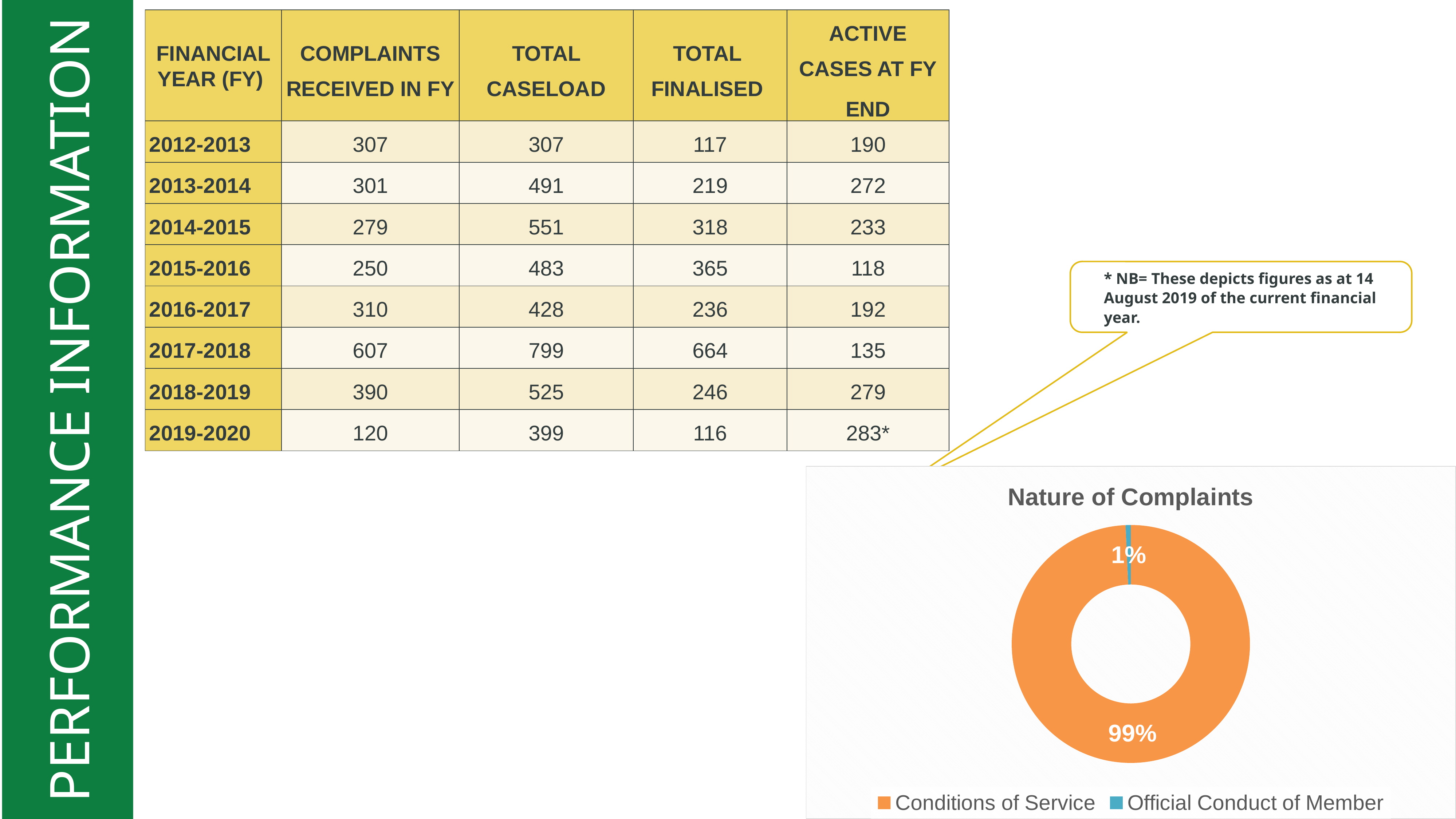
In the "Nature of Complaints" chart, what is the difference in percentage points between Conditions of Service and Official Conduct of Member? 98 In the "Nature of Complaints" chart, what share is labelled for Conditions of Service? 99% What is the title of the chart on the slide? Nature of Complaints What kind of chart is the "Nature of Complaints" chart? doughnut chart In the "Nature of Complaints" chart, what colour is the Conditions of Service slice? orange In the "Nature of Complaints" chart, which category has the smallest share? Official Conduct of Member How many categories does the legend of the "Nature of Complaints" chart list? 2 In the "Nature of Complaints" chart, which category has the largest share? Conditions of Service In the "Nature of Complaints" chart, what share is labelled for Official Conduct of Member? 1% In the "Nature of Complaints" chart, which is larger: Conditions of Service or Official Conduct of Member? Conditions of Service